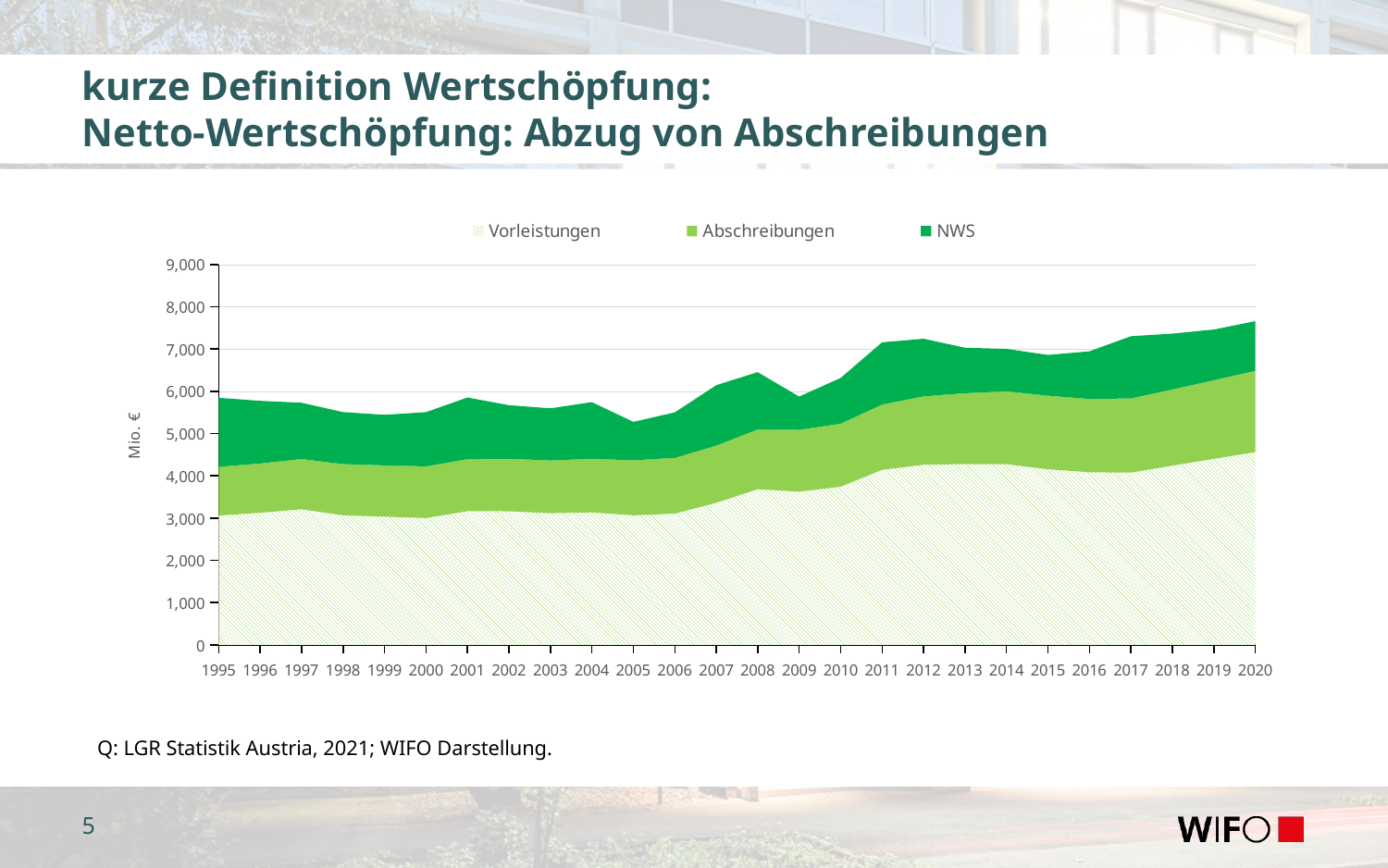
In which year is the total stacked value highest? 2020 What are the three series named in the legend? Vorleistungen, Abschreibungen, NWS Does the total stacked value generally rise or fall from 1995 to 2020? rise How many series does the legend list? 3 What is the first year shown on the x axis? 1995 What kind of chart is shown on the slide? stacked area chart How many years are shown along the x axis? 26 Is the value for Vorleistungen in 2020 greater or less than 4,000? greater What is the last year shown on the x axis? 2020 Is the total stacked value for 2020 greater or less than 7,000? greater Is the total stacked value for 1995 greater or less than 6,000? less What is the label on the vertical axis? Mio. €